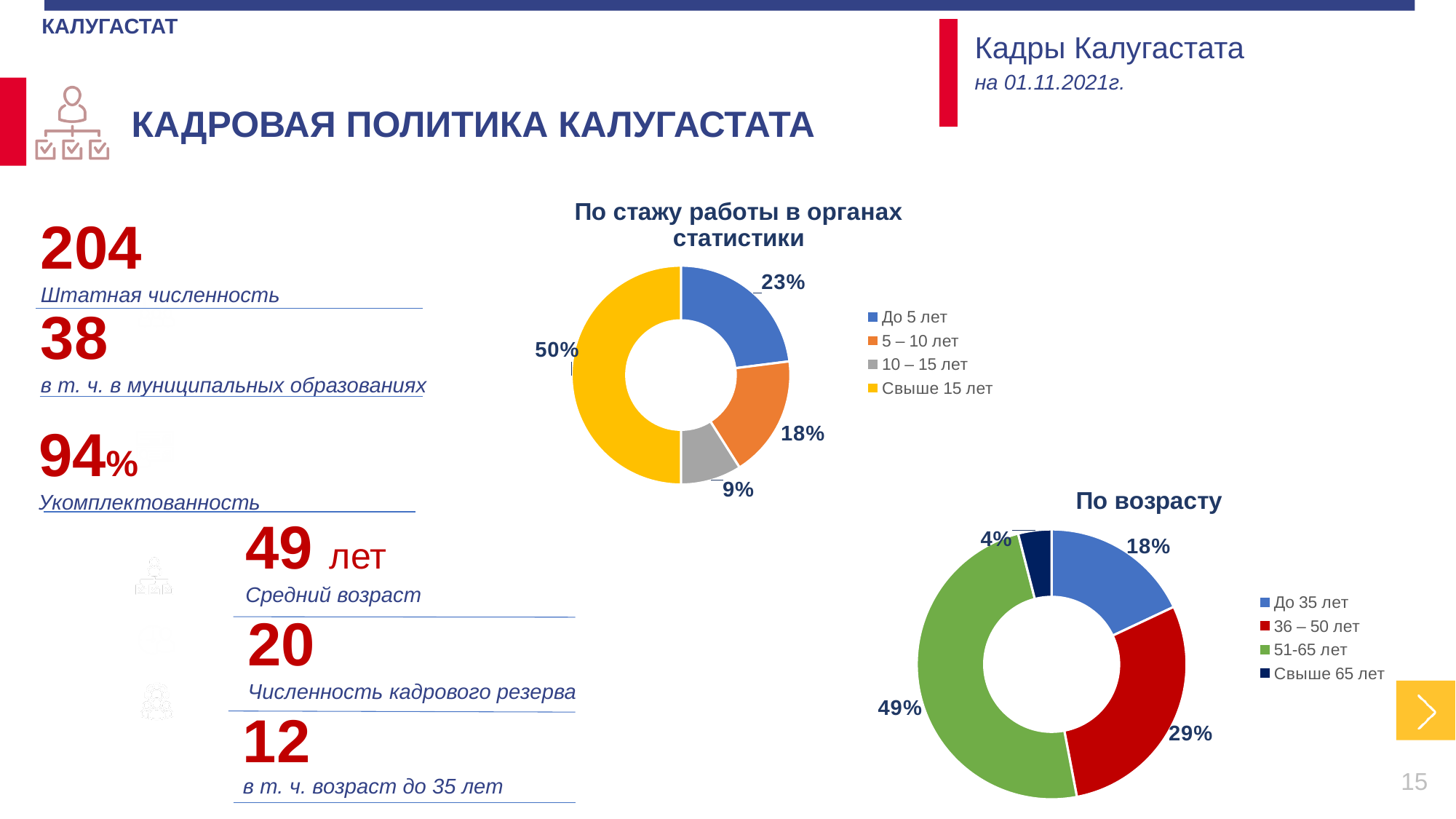
In the chart "По стажу работы в органах статистики", how many categories does the legend list? 4 In the chart "По возрасту", what share of staff is in the "36 – 50 лет" category? 29% In the chart "По стажу работы в органах статистики", which category has the largest share? Свыше 15 лет In the chart "По стажу работы в органах статистики", which category has the smallest share? 10 – 15 лет In the chart "По стажу работы в органах статистики", what share of staff falls in the "10 – 15 лет" category? 9% In the chart "По возрасту", which is larger: the share for "До 35 лет" or for "36 – 50 лет"? 36 – 50 лет In the chart "По возрасту", what share of staff is "Свыше 65 лет"? 4% What type of chart is "По возрасту"? Doughnut chart In the chart "По стажу работы в органах статистики", what is the difference in percentage points between "До 5 лет" and "5 – 10 лет"? 5 In the chart "По возрасту", which age group has the largest share? 51-65 лет In the chart "По возрасту", what is the difference in percentage points between "51-65 лет" and "До 35 лет"? 31 In the chart "По стажу работы в органах статистики", what share of staff has worked "Свыше 15 лет"? 50%